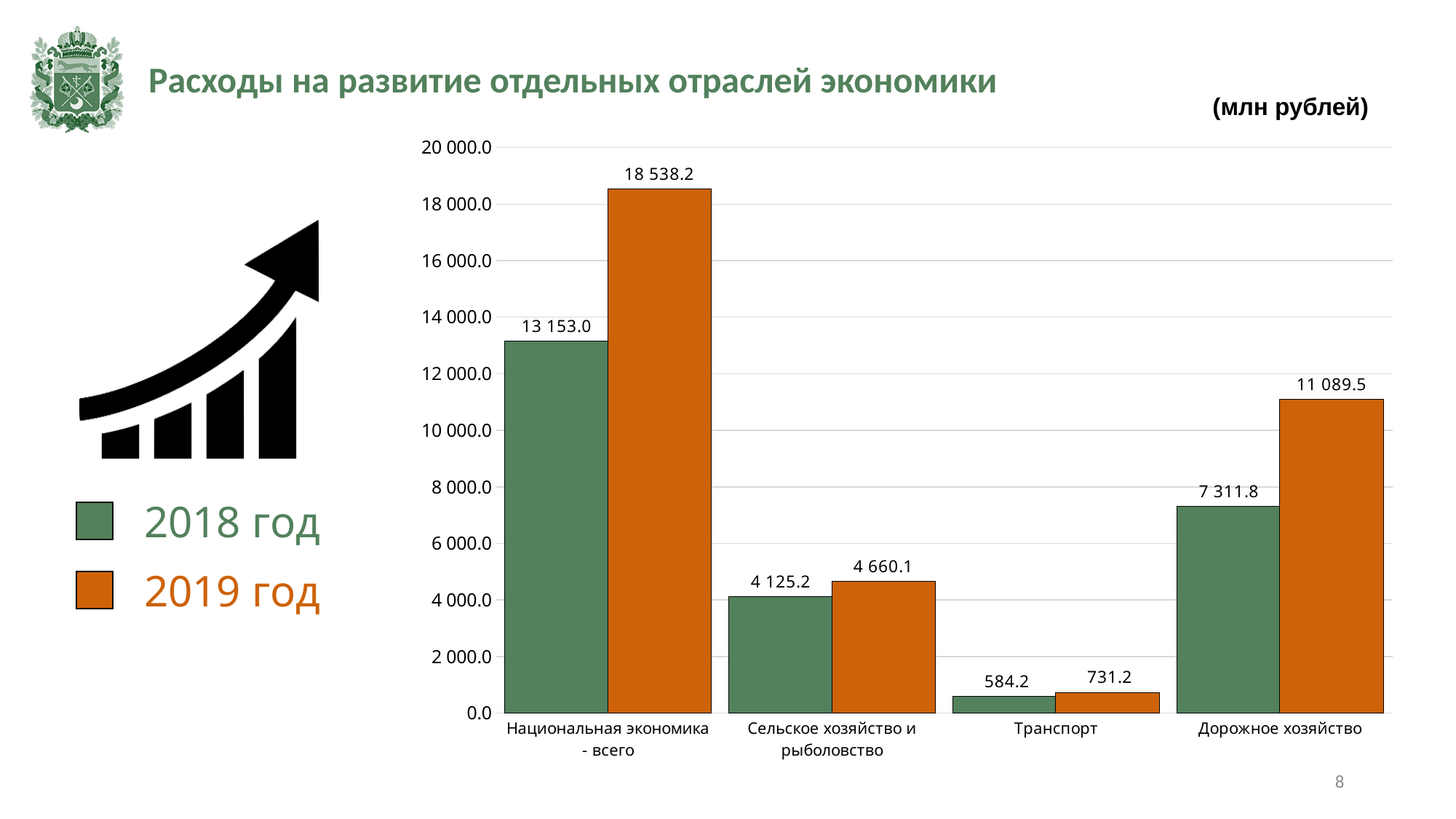
Which is larger: the 2018 value for Дорожное хозяйство or the 2019 value for Сельское хозяйство и рыболовство? 2018 value for Дорожное хозяйство How many series does the legend list? 2 Which category has the highest 2018 value? Национальная экономика - всего What is the 2019 value for Национальная экономика - всего? 18 538.2 What is the 2018 value for Транспорт? 584.2 What is the difference between the 2019 and 2018 values for Дорожное хозяйство? 3 777.7 What kind of chart is shown on the slide? Bar chart How many categories are shown on the x axis? 4 What is the difference between the 2019 and 2018 values for Транспорт? 147.0 What is the 2018 value for Сельское хозяйство и рыболовство? 4 125.2 What is the 2019 value for Дорожное хозяйство? 11 089.5 Which category has the lowest 2019 value? Транспорт